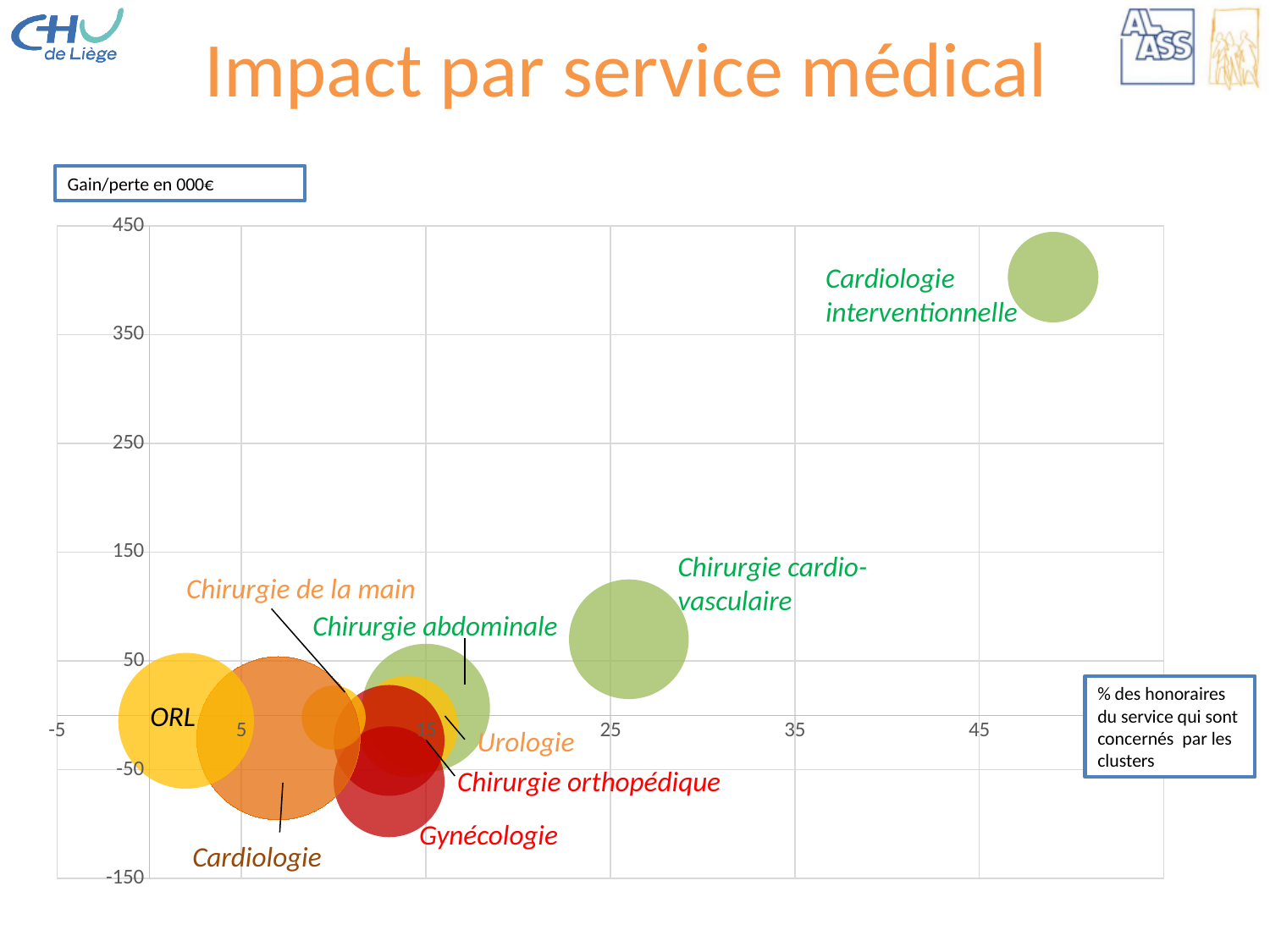
What is the title of the slide's chart? Impact par service médical Is the gain for Cardiologie interventionnelle greater or less than 350? greater Is the gain/perte value for Gynécologie greater or less than 50? less Which has the larger gain, Cardiologie interventionnelle or Chirurgie cardio-vasculaire? Cardiologie interventionnelle Which medical service has the lowest percentage of honoraires concerned by the clusters (furthest left)? ORL Which medical service has the lowest gain/perte value on the chart? Gynécologie Is the percentage of honoraires for Chirurgie cardio-vasculaire greater or less than 35? less How many medical services are labelled as bubbles on the chart? 9 Which medical service has the highest gain on the chart? Cardiologie interventionnelle What kind of chart is shown on the slide? bubble chart What does the vertical axis of the chart represent, according to the label box? Gain/perte en 000€